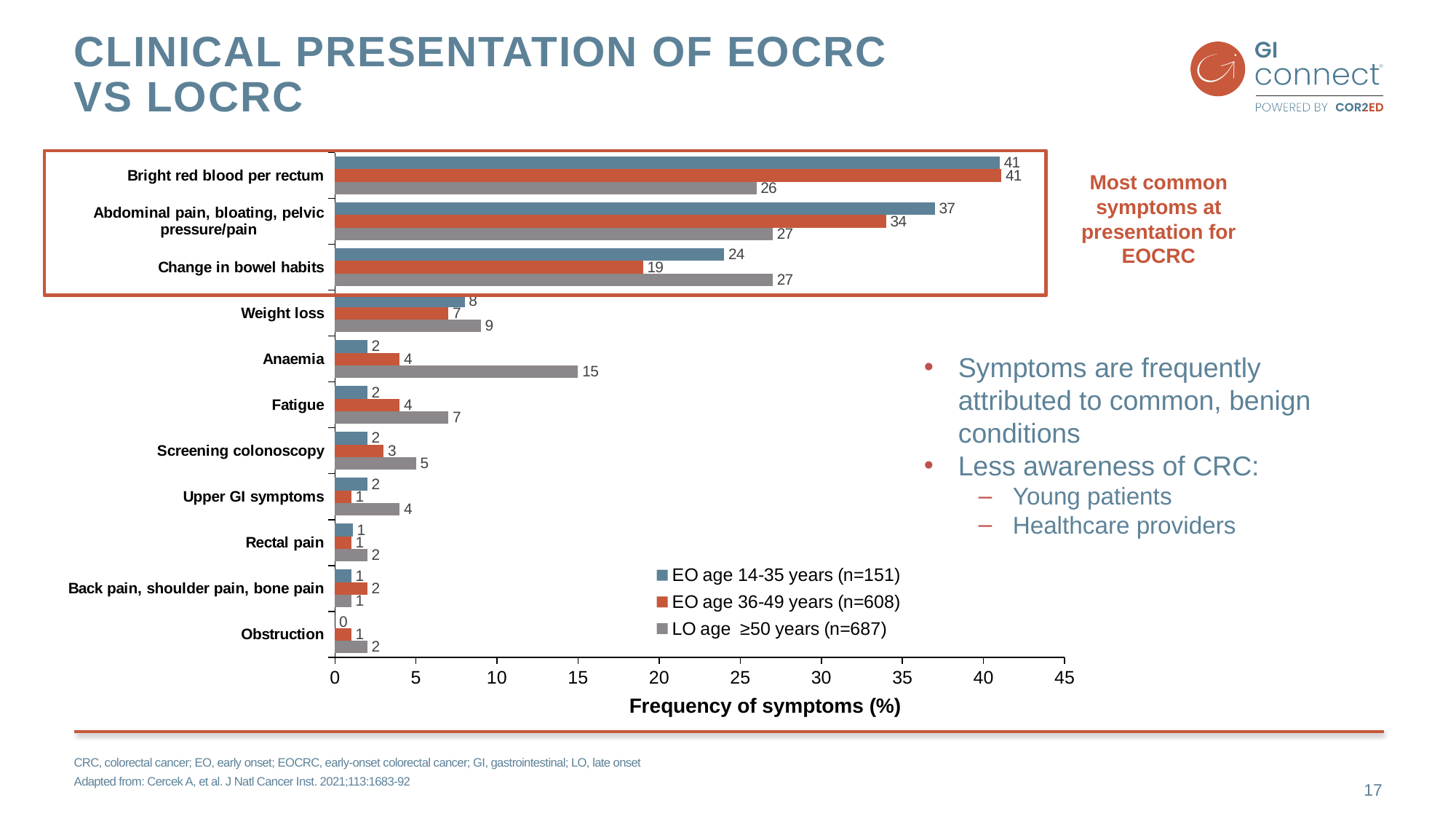
How many symptom categories are shown on the chart? 11 What is the label of the x axis? Frequency of symptoms (%) What is the difference between the EO age 14-35 years and LO age ≥50 years values for Bright red blood per rectum? 15 What is the value for Bright red blood per rectum in the EO age 14-35 years (n=151) series? 41 Is the value for Abdominal pain, bloating, pelvic pressure/pain in the EO age 14-35 years series greater or less than 35? greater How many series does the legend list? 3 Which symptom has the lowest value in the EO age 14-35 years (n=151) series? Obstruction What kind of chart is shown on the slide? Bar chart For Change in bowel habits, which is larger: the EO age 14-35 years value or the LO age ≥50 years value? LO age ≥50 years What is the value for Change in bowel habits in the EO age 36-49 years (n=608) series? 19 What is the value for Anaemia in the LO age ≥50 years (n=687) series? 15 Which symptom has the highest value in the EO age 14-35 years (n=151) series? Bright red blood per rectum